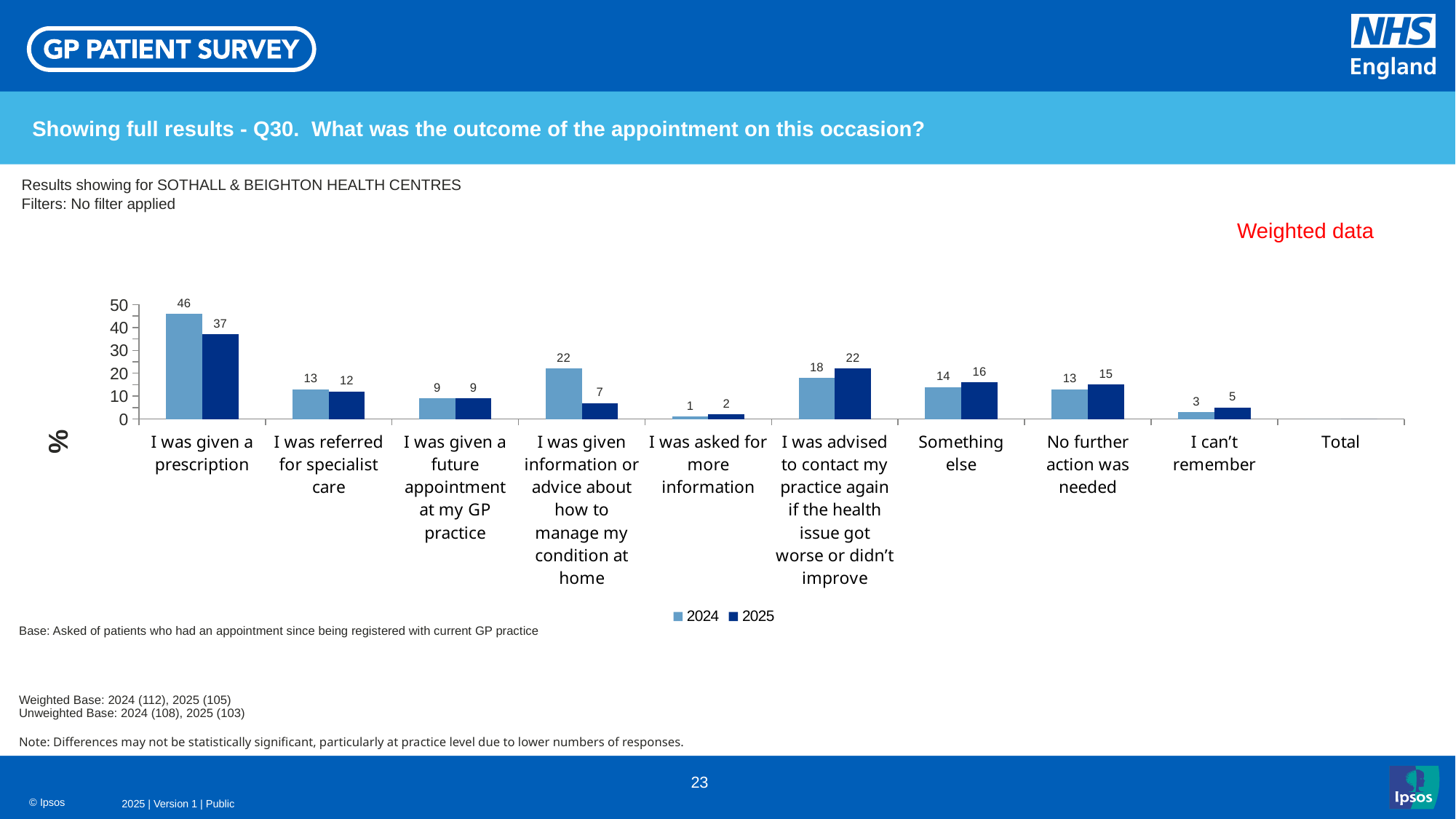
What is the difference between the 2024 and 2025 values for "I was given a prescription"? 9 Which category has the lowest 2024 value? I was asked for more information Which category has the highest 2025 value? I was given a prescription What kind of chart is shown on the slide? Bar chart Is the 2024 value for "I was given information or advice about how to manage my condition at home" greater or less than 20? greater What is the 2025 value for "No further action was needed"? 15 What is the 2025 value for "I was given information or advice about how to manage my condition at home"? 7 How many series does the legend list? 2 Which two years are listed in the chart legend? 2024 and 2025 What is the 2024 value for "I can't remember"? 3 What is the 2024 value for "I was given a prescription"? 46 For "I was advised to contact my practice again if the health issue got worse or didn't improve", which year has the larger value, 2024 or 2025? 2025